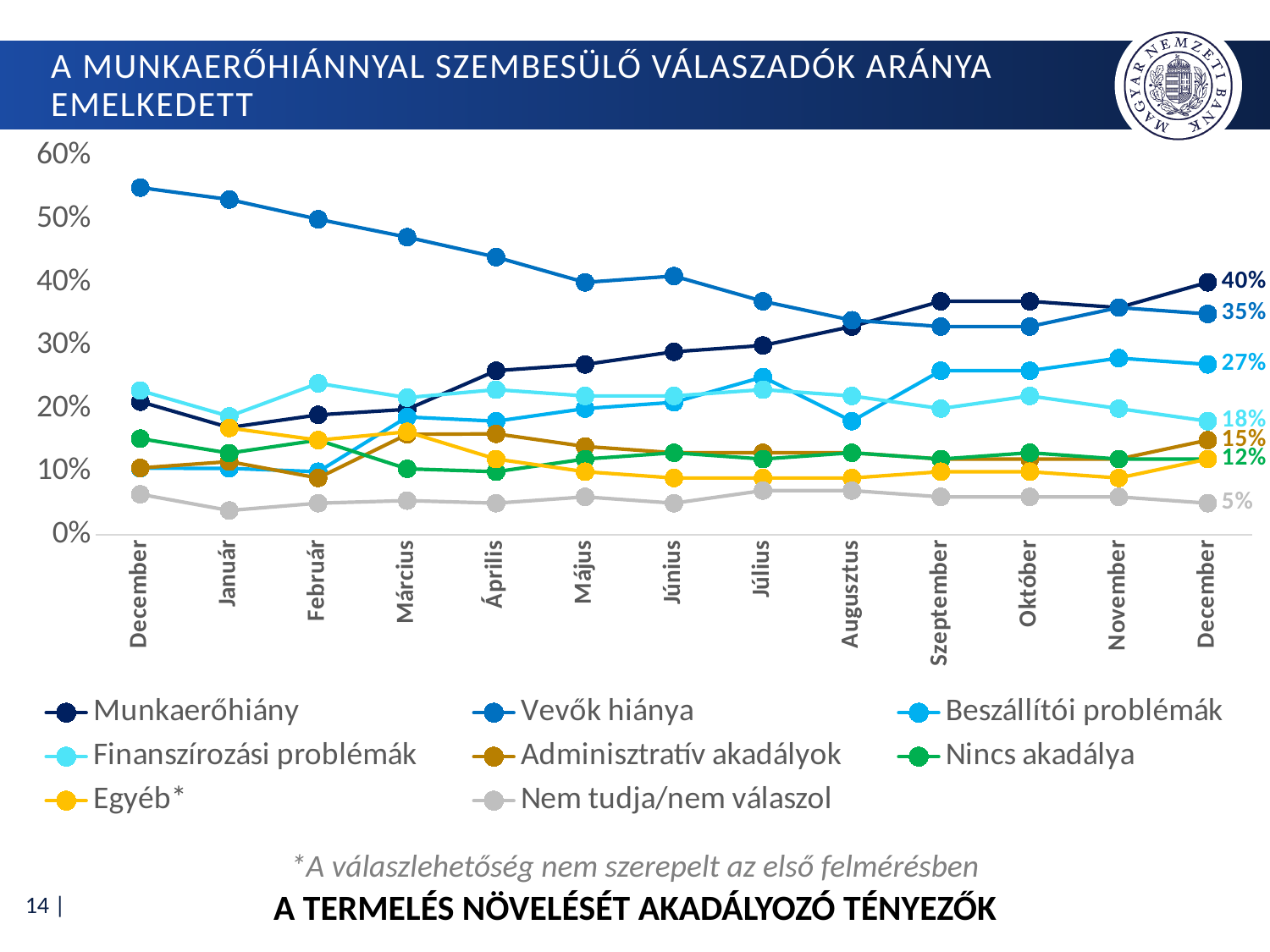
What is the value for Munkaerőhiány at the final December point? 40% Is the value for Vevők hiánya at the first December point greater or less than 50%? greater At the final December point, how much higher is Munkaerőhiány than Vevők hiánya? 5 percentage points Does the Vevők hiánya series rise or fall from the first December to the last December? fall What kind of chart is shown on the slide? line chart What is the value for Nem tudja/nem válaszol at the final December point? 5% What is the value for Vevők hiánya at the final December point? 35% At the final December point, which series has the lowest value? Nem tudja/nem válaszol What is the value for Beszállítói problémák at the final December point? 27% At the final December point, which series has the highest value? Munkaerőhiány How many series does the legend list? 8 How many time points are shown on the x axis? 13